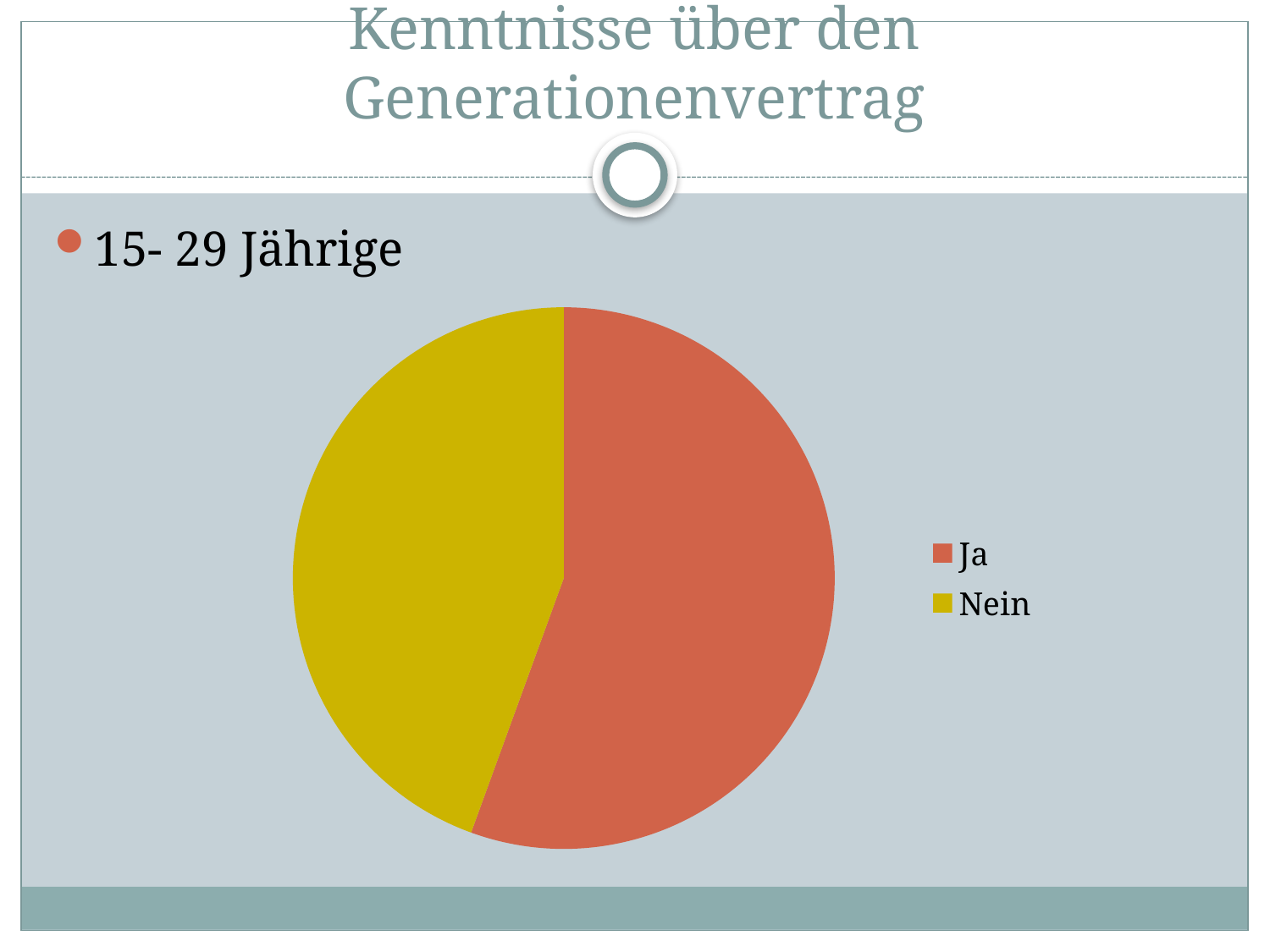
What are the two legend entries of the pie chart? Ja, Nein How many slices does the pie chart have? 2 Which slice of the pie chart is the smallest? Nein Which slice of the pie chart is the largest? Ja How many entries does the legend of the pie chart list? 2 What kind of chart is shown on the slide? pie chart Which slice is larger in the pie chart, Ja or Nein? Ja What colour is the Nein slice in the pie chart? yellow